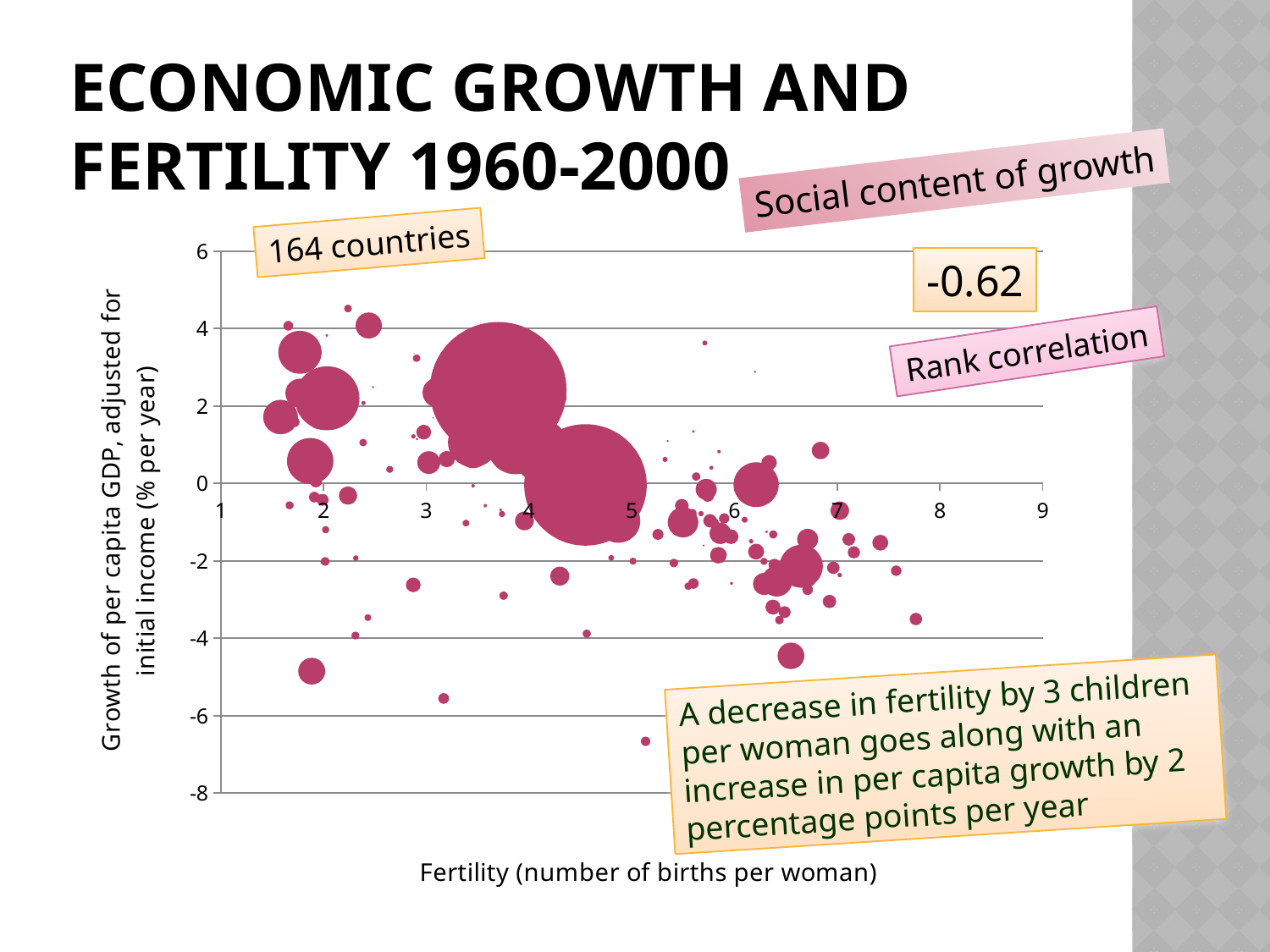
As fertility increases along the x axis, do the growth values generally rise or fall? Fall Is the growth value of the lowest plotted point greater or less than -6? less Is the growth value of the largest bubble greater or less than 0? greater How many countries does the chart say are plotted? 164 countries What rank correlation value is shown on the slide? -0.62 What is the label of the x axis? Fertility (number of births per woman) What kind of chart is shown on the slide? Bubble chart